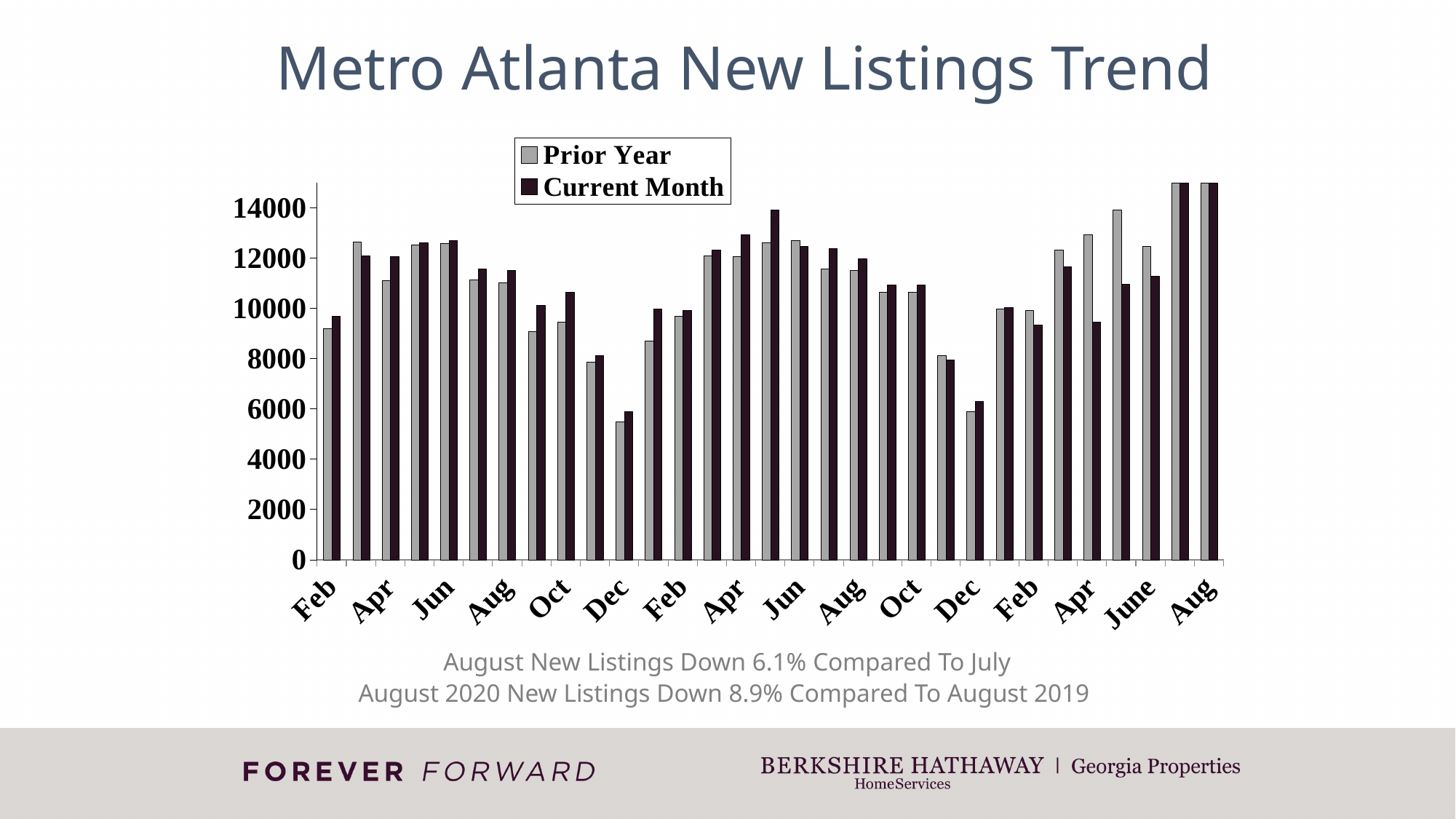
What is the title of the chart? Metro Atlanta New Listings Trend For the last June, which is larger: the Prior Year value or the Current Month value? Prior Year What kind of chart is shown on the slide? bar chart Is the Current Month value for the second Apr greater or less than 12000? greater Which series is shown in the darker bars according to the legend? Current Month For the second Jun, which is larger: the Prior Year value or the Current Month value? Prior Year How many series does the legend list? 2 For the first Dec, which is larger: the Prior Year value or the Current Month value? Current Month Is the Current Month value for the second Dec greater or less than 6000? greater Which month has the lowest Prior Year value? the first Dec Is the Prior Year value for the first Feb greater or less than 10000? less